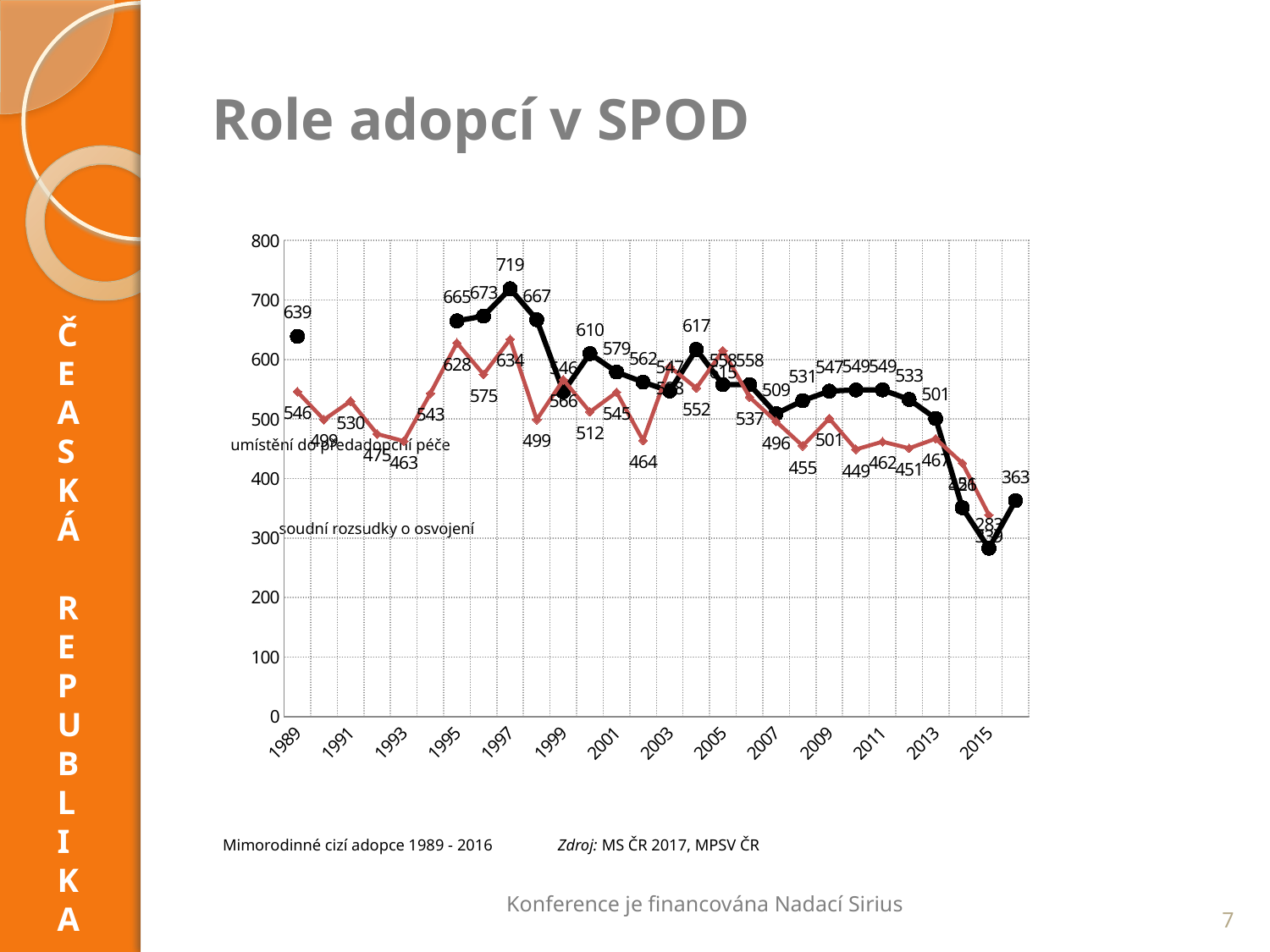
In 1997, which series has the larger value: 'soudní rozsudky o osvojení' or 'umístění do předadopční péče'? soudní rozsudky o osvojení What is the title of the slide containing the chart? Role adopcí v SPOD What is the difference between the 'soudní rozsudky o osvojení' values in 1997 and 1989? 80 What is the value of 'soudní rozsudky o osvojení' in 1989? 639 What is the highest value of 'soudní rozsudky o osvojení'? 719 What kind of chart is shown on the slide? line chart Is the value of 'soudní rozsudky o osvojení' in 2015 greater or less than 300? less In which year does 'soudní rozsudky o osvojení' reach its highest value? 1997 How many data series are plotted on the chart? 2 Does 'soudní rozsudky o osvojení' rise or fall between 2011 and 2015? fall What is the value of 'umístění do předadopční péče' in 1989? 546 What is the value of 'soudní rozsudky o osvojení' in 2016? 363